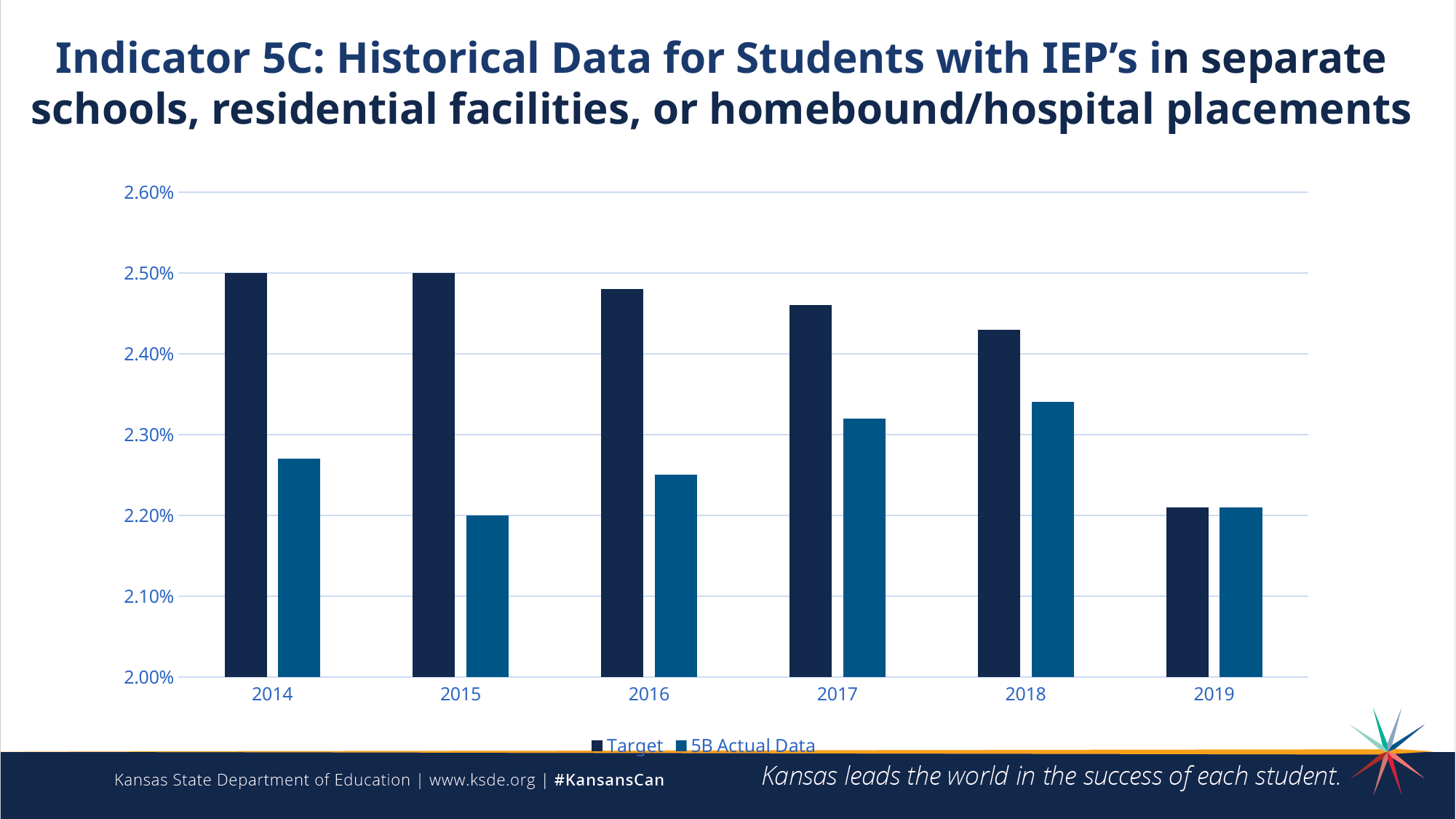
Which year has the lowest 5B Actual Data value? 2015 Is the 5B Actual Data value for 2018 greater or less than 2.30%? greater What is the Target value for 2014? 2.50% What kind of chart is shown on the slide? bar chart How many years are shown on the x axis of the chart? 6 Which year has the highest 5B Actual Data value? 2018 Is the 5B Actual Data value for 2014 greater or less than 2.30%? less How many series does the chart's legend list? 2 Does the Target series rise or fall from 2014 to 2019? fall What is the 5B Actual Data value for 2015? 2.20% What are the two series named in the legend? Target and 5B Actual Data Is the Target value for 2019 greater or less than 2.30%? less